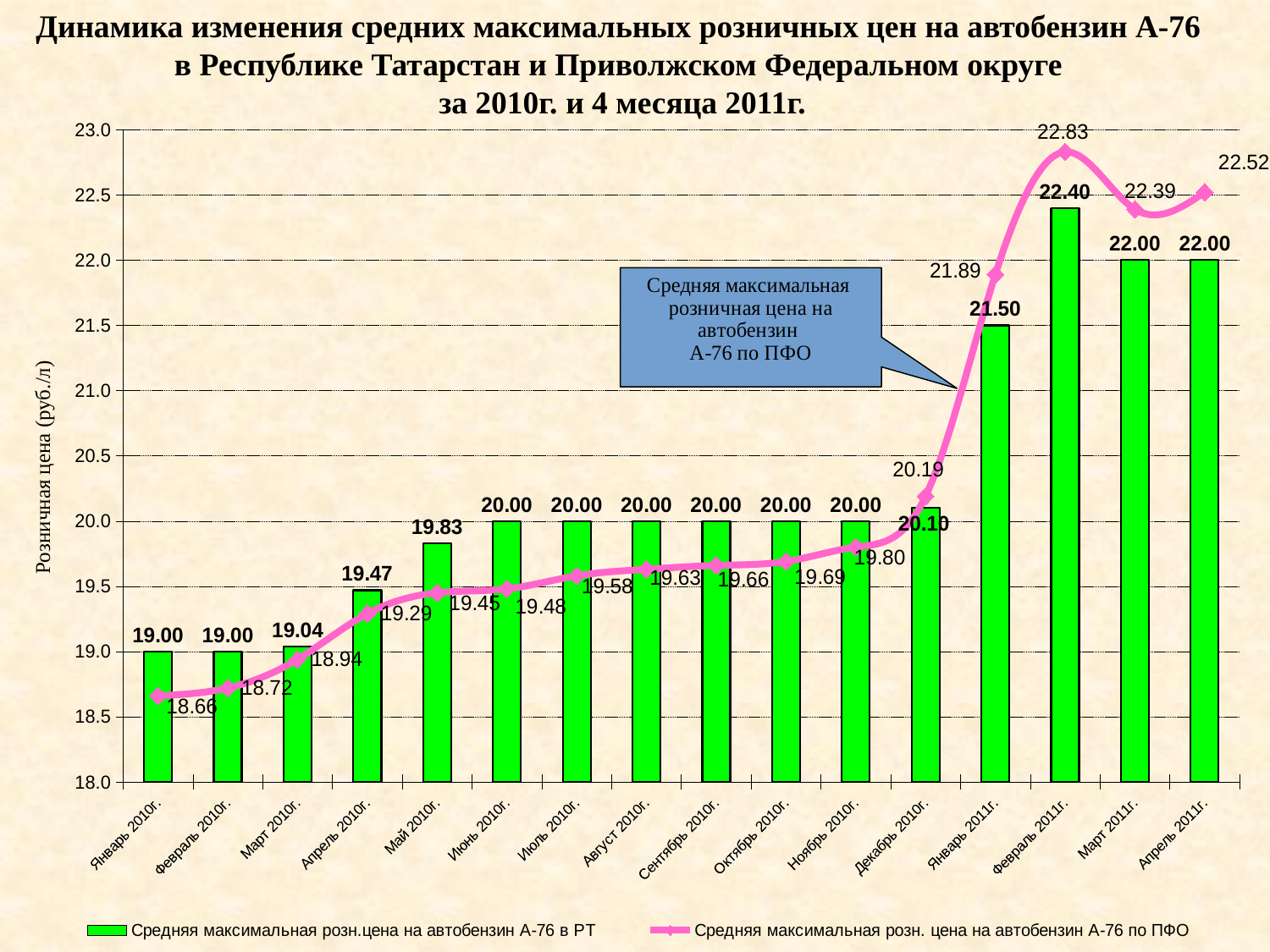
Which month has the highest value on the pink line (ПФО series)? Февраль 2011г. Which is larger for Декабрь 2010г.: the green bar (RT) or the pink line (ПФО)? the pink line (ПФО), 20.19 What is the value of the pink line (ПФО series) for Январь 2010г.? 18.66 Is the green bar value for Январь 2011г. greater or less than 21.0? greater Does the pink line (ПФО series) generally rise or fall from Январь 2010г. to Февраль 2011г.? rise What is the difference between the green bar values for Февраль 2011г. and Январь 2011г.? 0.90 How many months are shown on the x axis? 16 How many series does the legend list? 2 What is the value of the green bar (RT series) for Февраль 2011г.? 22.40 What kind of chart is shown on the slide? a combined bar and line chart What is the value of the pink line (ПФО series) for Апрель 2011г.? 22.52 Which month has the lowest value on the pink line (ПФО series)? Январь 2010г.